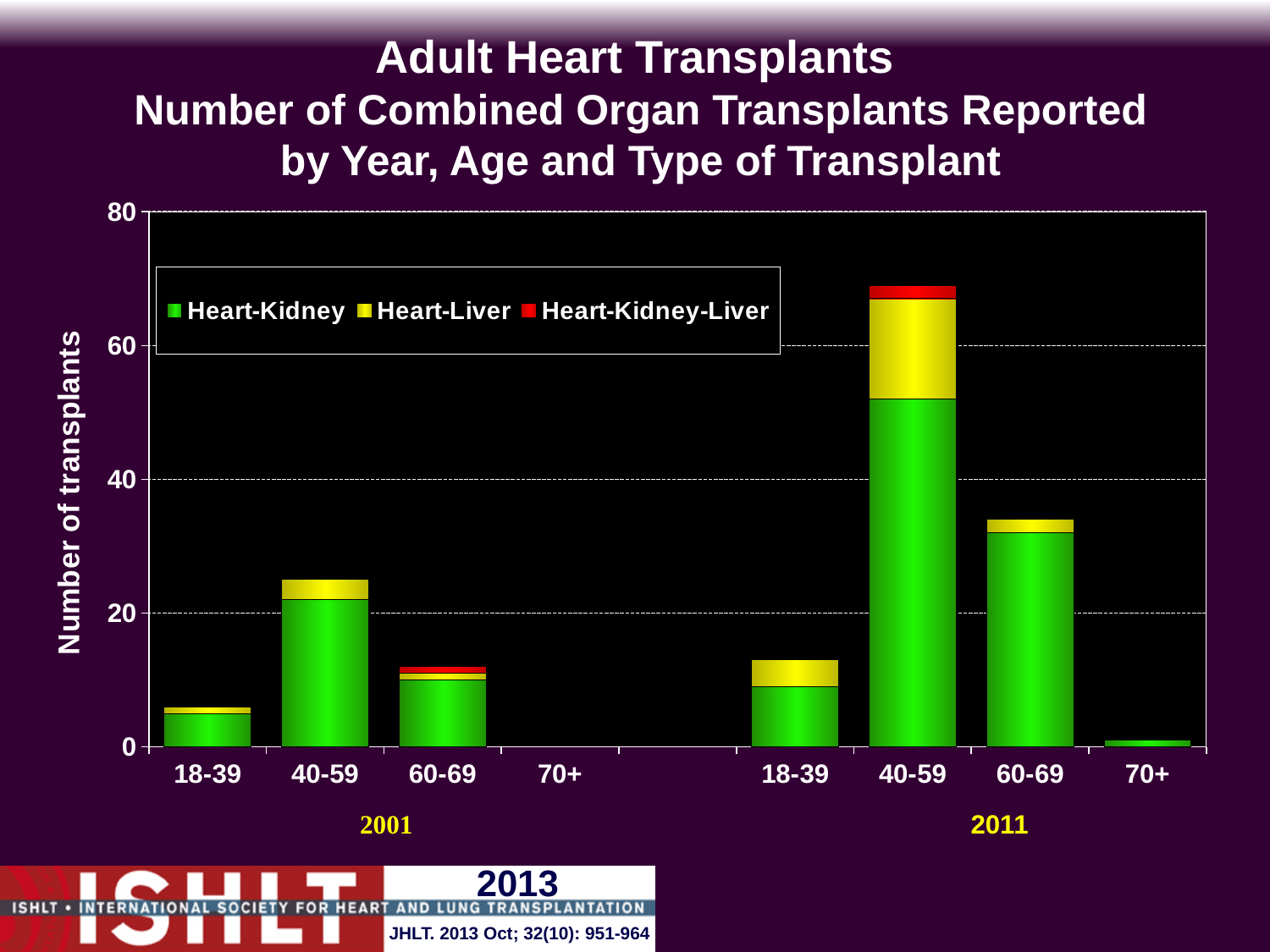
Which has a larger total: the 60-69 age group in 2001 or the 60-69 age group in 2011? 60-69 in 2011 What is the label on the vertical axis? Number of transplants Which age group in 2011 has the tallest stacked bar? 40-59 Is the total for the 60-69 age group in 2011 greater or less than 20? greater Is the total for the 40-59 age group in 2011 greater or less than 60? greater How many series does the legend list? 3 Which age group in 2001 has the lowest total number of transplants? 70+ Is the total for the 40-59 age group in 2001 greater or less than 40? less How many age groups are shown for each year on the x axis? 4 Which age group in 2001 has the tallest stacked bar? 40-59 What kind of chart is shown on the slide? bar chart Which series is shown in red in the legend? Heart-Kidney-Liver